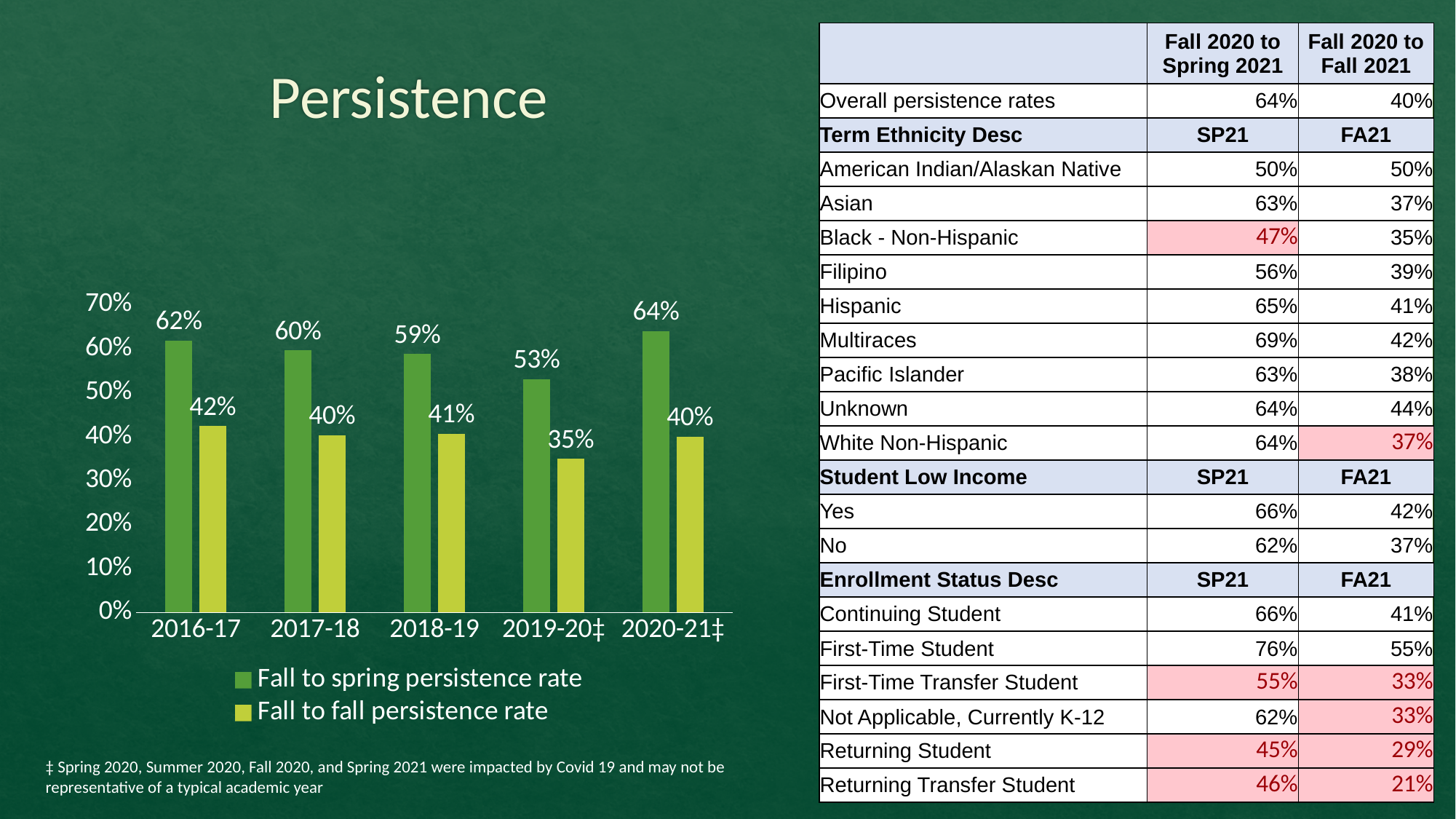
Which is larger, the fall to fall persistence rate for 2016-17 or for 2017-18? 2016-17 How many academic years are shown on the x axis of the chart? 5 How many series does the chart legend list? 2 Which year has the highest fall to spring persistence rate? 2020-21‡ Which series is shown in the lighter yellow-green colour in the chart? Fall to fall persistence rate What kind of chart is shown on the slide? Bar chart Which year has the lowest fall to fall persistence rate? 2019-20‡ What is the fall to spring persistence rate for 2020-21‡? 64% What is the fall to fall persistence rate for 2019-20‡? 35% What is the difference between the fall to spring and fall to fall persistence rates in 2018-19? 18% Is the fall to spring persistence rate for 2019-20‡ greater or less than 50%? greater What is the fall to spring persistence rate for 2016-17? 62%